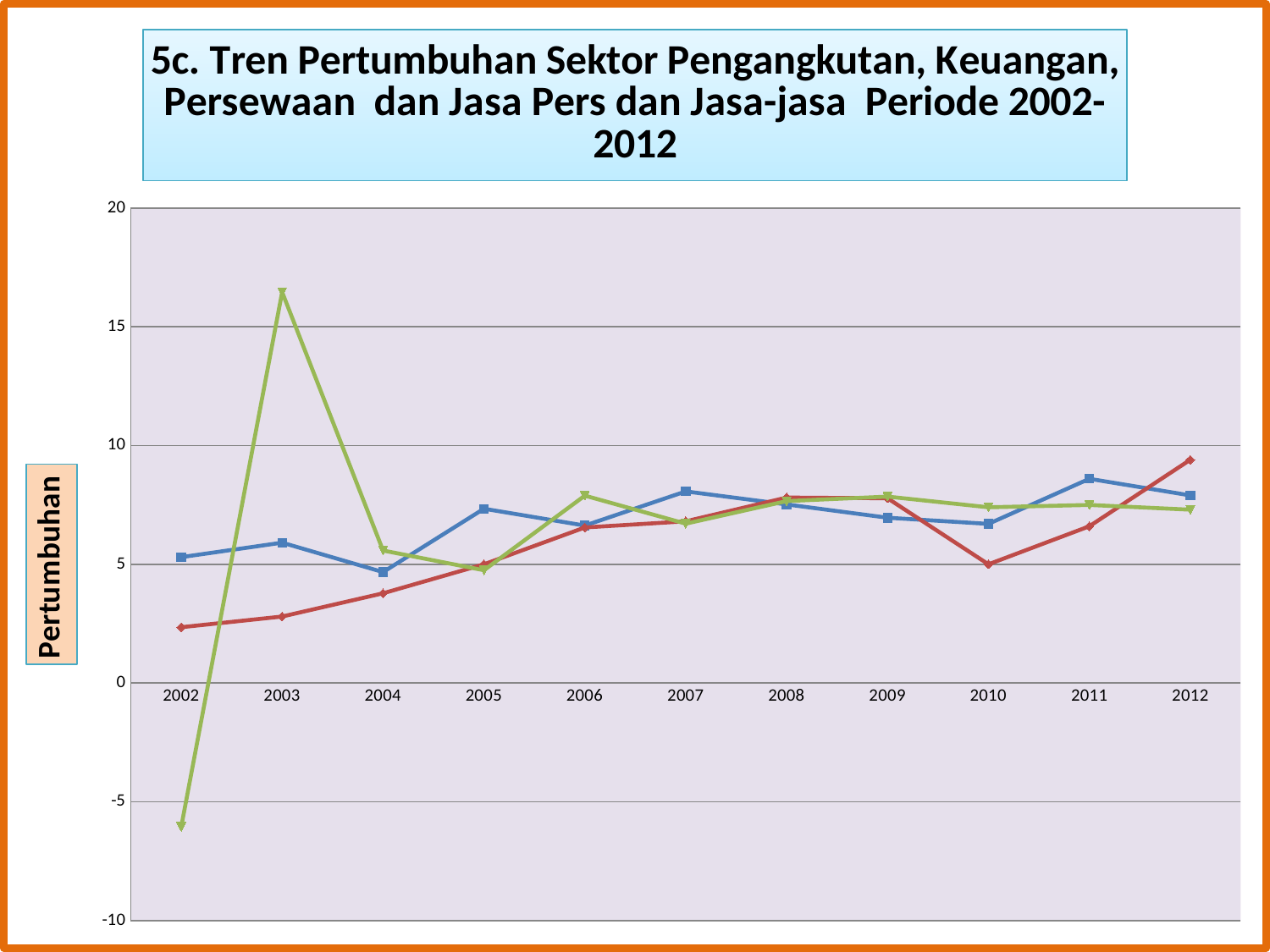
Is the value of the green line in 2003 greater or less than 15? greater In 2010, which line has the higher value, the blue line or the red line? blue line How many years are shown on the x axis of the chart? 11 In which year does the green line reach its lowest value? 2002 In which year does the green line reach its highest value? 2003 How many lines are plotted on the chart? 3 Is the value of the red line in 2012 greater or less than 5? greater Is the value of the red line in 2002 greater or less than 5? less What period does the chart title say the data covers? 2002-2012 What is the label on the vertical axis of the chart? Pertumbuhan What type of chart is shown on the slide? line chart